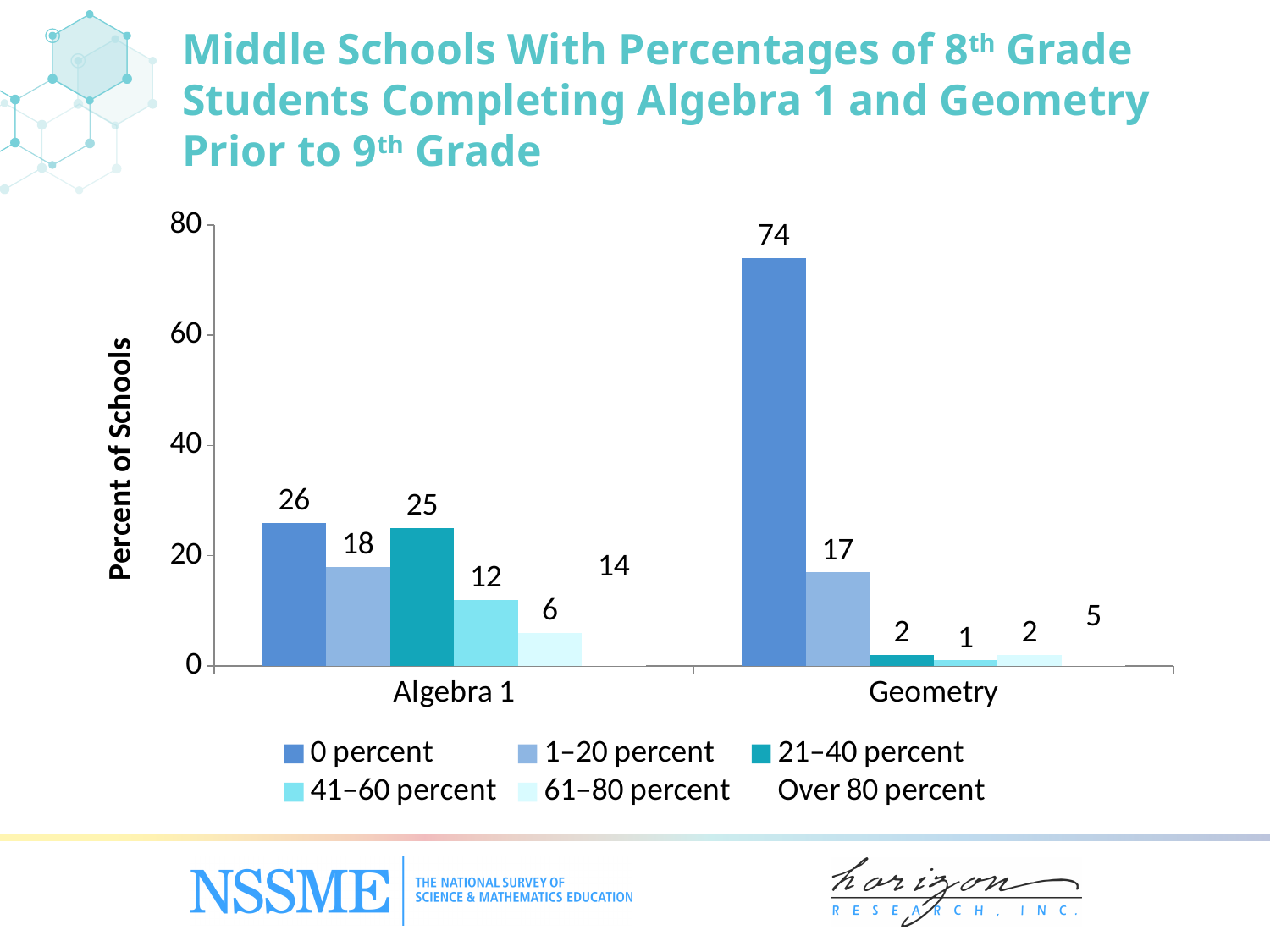
What is the value for the 1–20 percent series in the Geometry category? 17 How many series does the legend list? 6 Which is larger: the 41–60 percent value for Algebra 1 or the 41–60 percent value for Geometry? Algebra 1 How many categories are shown on the x axis? 2 What is the difference between the 0 percent values for Geometry and Algebra 1? 48 What percent of schools have 0 percent of 8th grade students completing Geometry prior to 9th grade? 74 What kind of chart is shown on the slide? Bar chart What percent of schools have 21–40 percent of 8th grade students completing Algebra 1 prior to 9th grade? 25 Which series has the highest value in the Geometry category? 0 percent What is the value for the Over 80 percent series in the Algebra 1 category? 14 What is the label of the y axis? Percent of Schools Which series has the lowest value in the Geometry category? 41–60 percent